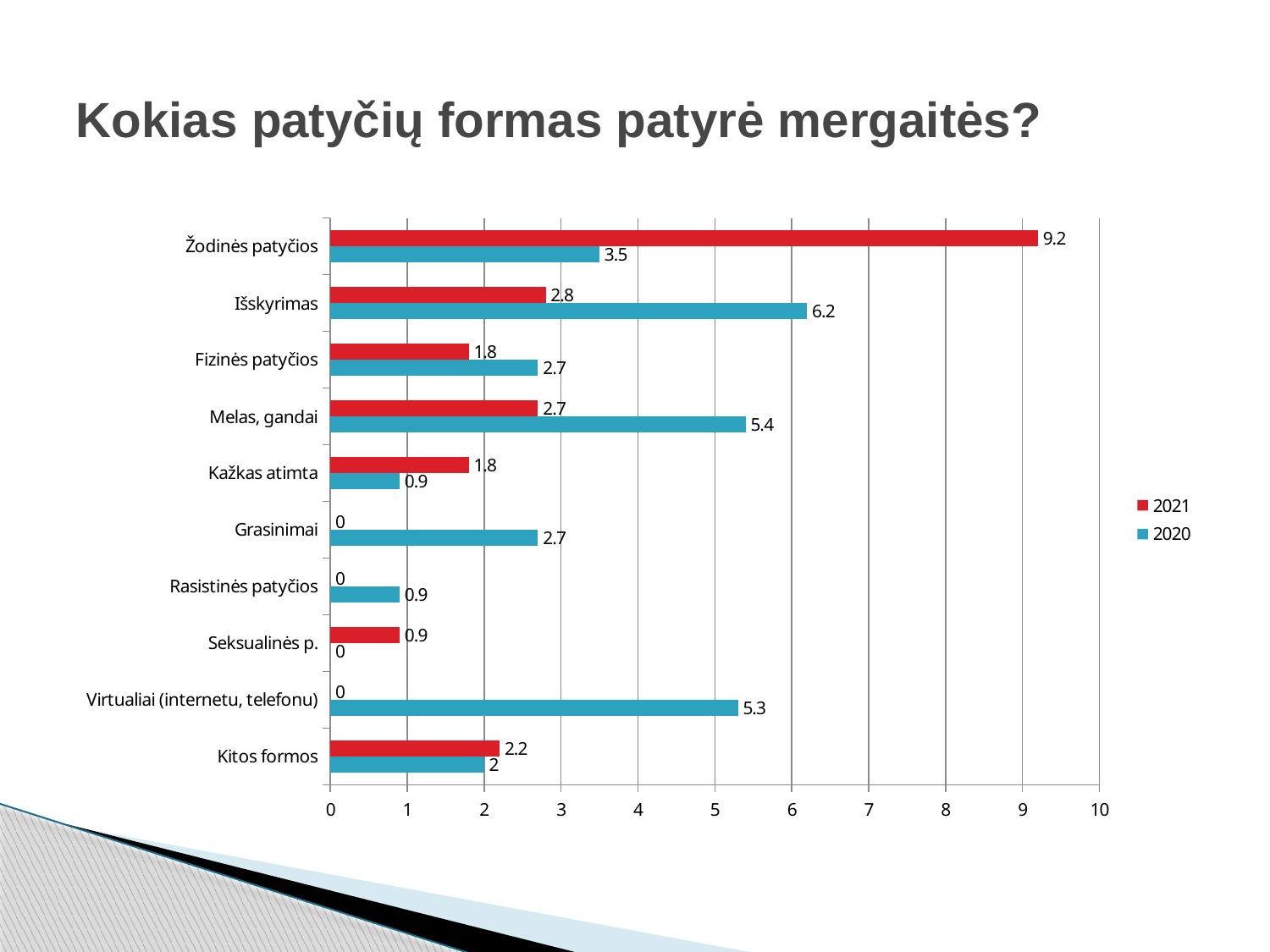
Which category has the highest 2021 value? Žodinės patyčios What is the 2021 value for Žodinės patyčios? 9.2 What is the difference between the 2021 and 2020 values for Žodinės patyčios? 5.7 What is the difference between the 2020 and 2021 values for Melas, gandai? 2.7 What kind of chart is shown on the slide? Bar chart What is the 2020 value for Virtualiai (internetu, telefonu)? 5.3 How many categories are shown on the chart? 10 How many series does the legend list? 2 Which category has the highest 2020 value? Išskyrimas What is the 2020 value for Išskyrimas? 6.2 What is the title of the slide? Kokias patyčių formas patyrė mergaitės? Which is larger for Kažkas atimta, the 2021 value or the 2020 value? 2021